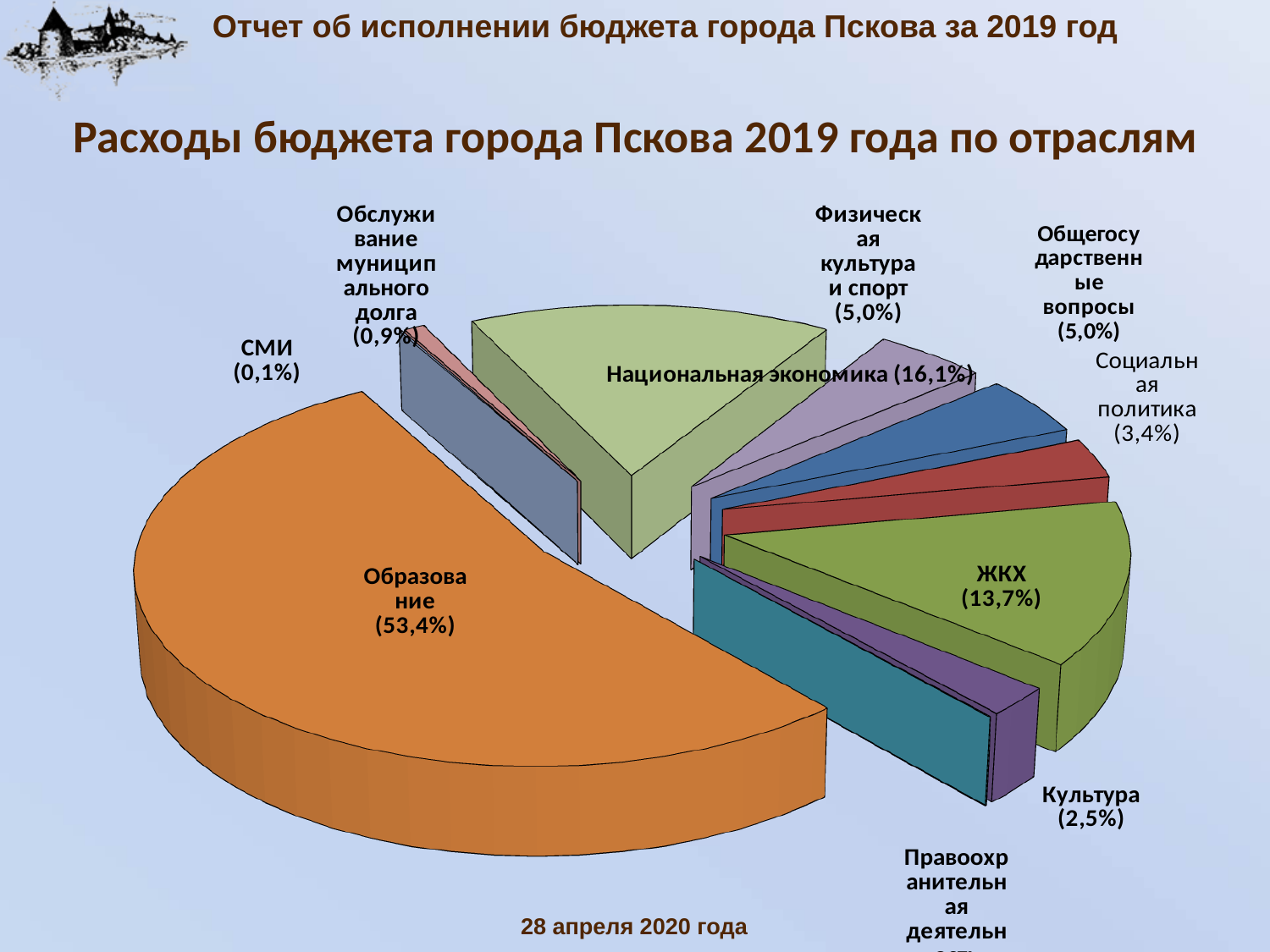
What share of the 2019 Pskov city budget expenditures went to Образование? 53,4% What percentage is shown for Национальная экономика? 16,1% What is the difference in percentage points between Образование and ЖКХ? 39,7 What kind of chart is shown on the slide? Pie chart What is the title of the chart? Расходы бюджета города Пскова 2019 года по отраслям What percentage is shown for ЖКХ? 13,7% What percentage is shown for Социальная политика? 3,4% Which is larger, the share for Национальная экономика or the share for ЖКХ? Национальная экономика Which sector has the largest share of expenditures? Образование What is the difference in percentage points between Культура and Обслуживание муниципального долга? 1,6 What percentage is shown for Обслуживание муниципального долга? 0,9%